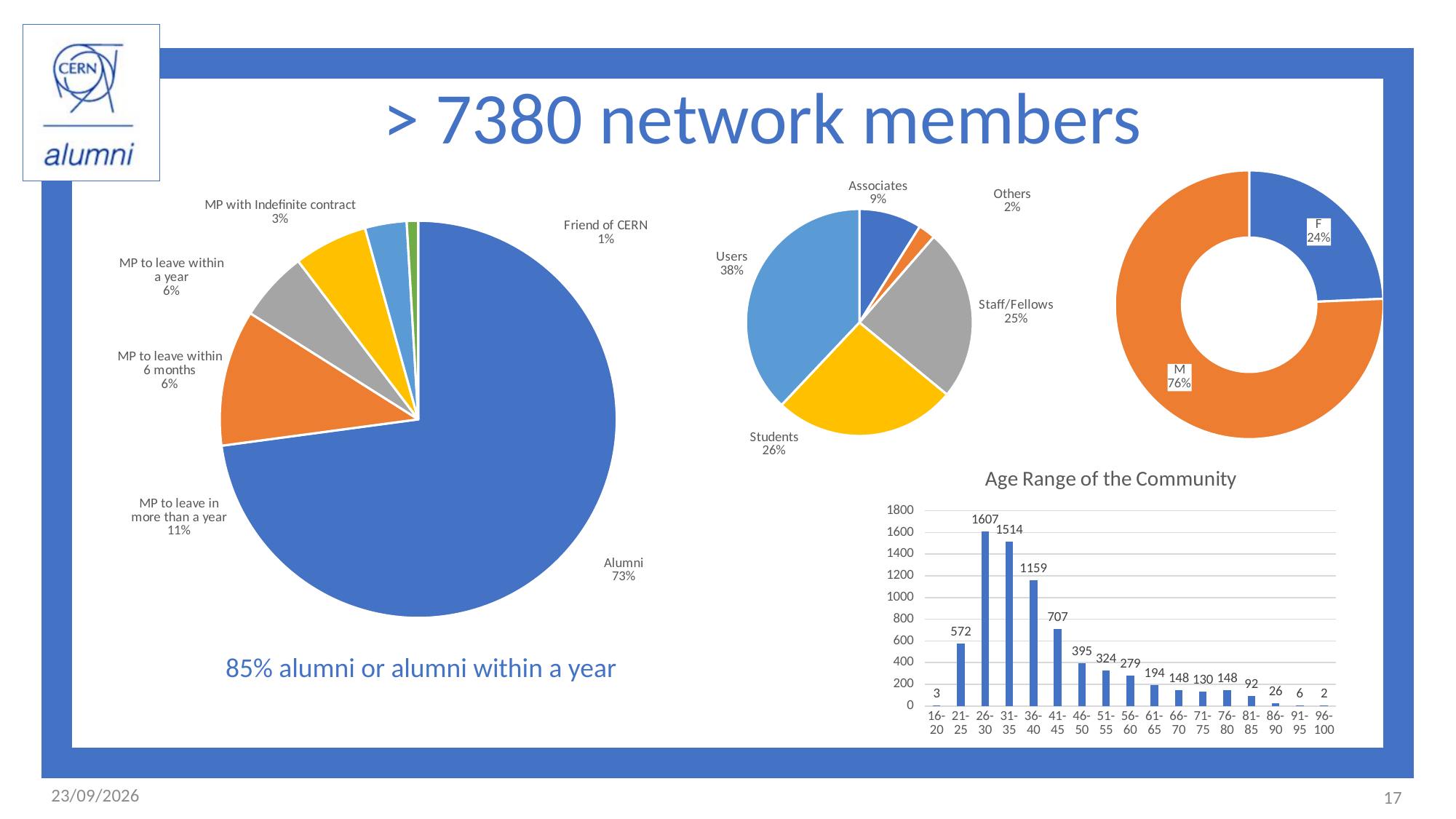
In the 'Age Range of the Community' chart, what is the difference between the values for 26-30 and 31-35? 93 In the 'Age Range of the Community' chart, how many age ranges are shown on the x axis? 17 In the small pie chart at the top middle, which category has the largest share? Users In the large pie chart on the left, what share does the Alumni slice have? 73% What kind of chart is 'Age Range of the Community'? bar chart In the 'Age Range of the Community' chart, do the values rise or fall from the 36-40 range to the 61-65 range? fall In the 'Age Range of the Community' chart, which age range has the highest value? 26-30 In the 'Age Range of the Community' chart, which age range has the lowest value? 96-100 In the donut chart at the top right, what share is labelled M? 76% In the 'Age Range of the Community' chart, what is the value for the 26-30 age range? 1607 In the large pie chart on the left, how many slices are there? 6 In the small pie chart at the top middle, which is larger: Students or Staff/Fellows? Students